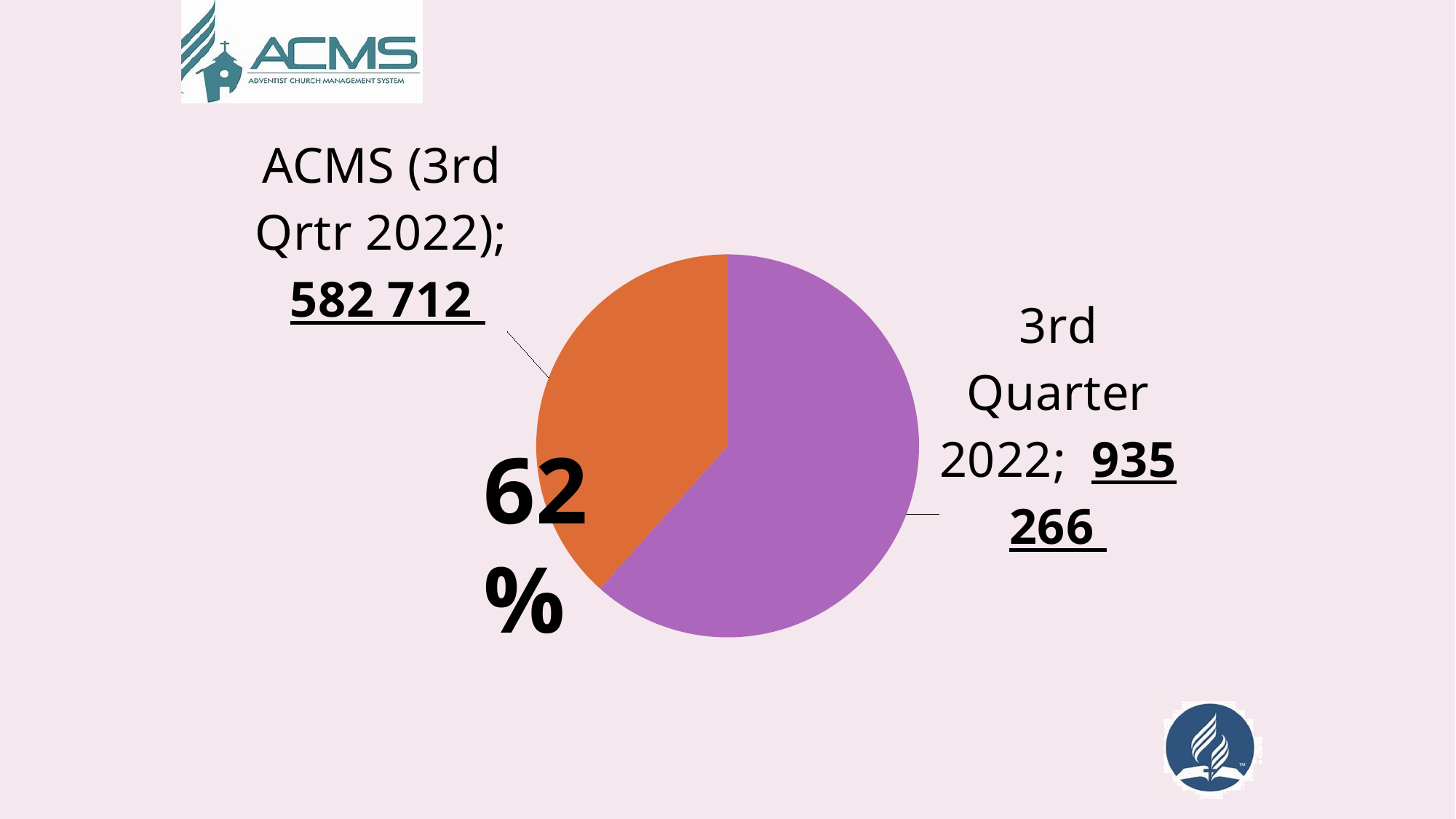
Which is larger, the value for ACMS (3rd Qrtr 2022) or the value for 3rd Quarter 2022? 3rd Quarter 2022 Which slice has the larger value? 3rd Quarter 2022 What kind of chart is shown on the slide? pie chart How many slices does the pie chart have? 2 What is the difference between the value for 3rd Quarter 2022 and the value for ACMS (3rd Qrtr 2022)? 352 554 What is the value for 3rd Quarter 2022? 935 266 What colour is the slice for ACMS (3rd Qrtr 2022)? orange What is the total of the two values shown on the pie chart? 1 517 978 Which slice has the smaller value? ACMS (3rd Qrtr 2022) What percentage is printed in large text next to the pie chart? 62% What is the value for ACMS (3rd Qrtr 2022)? 582 712